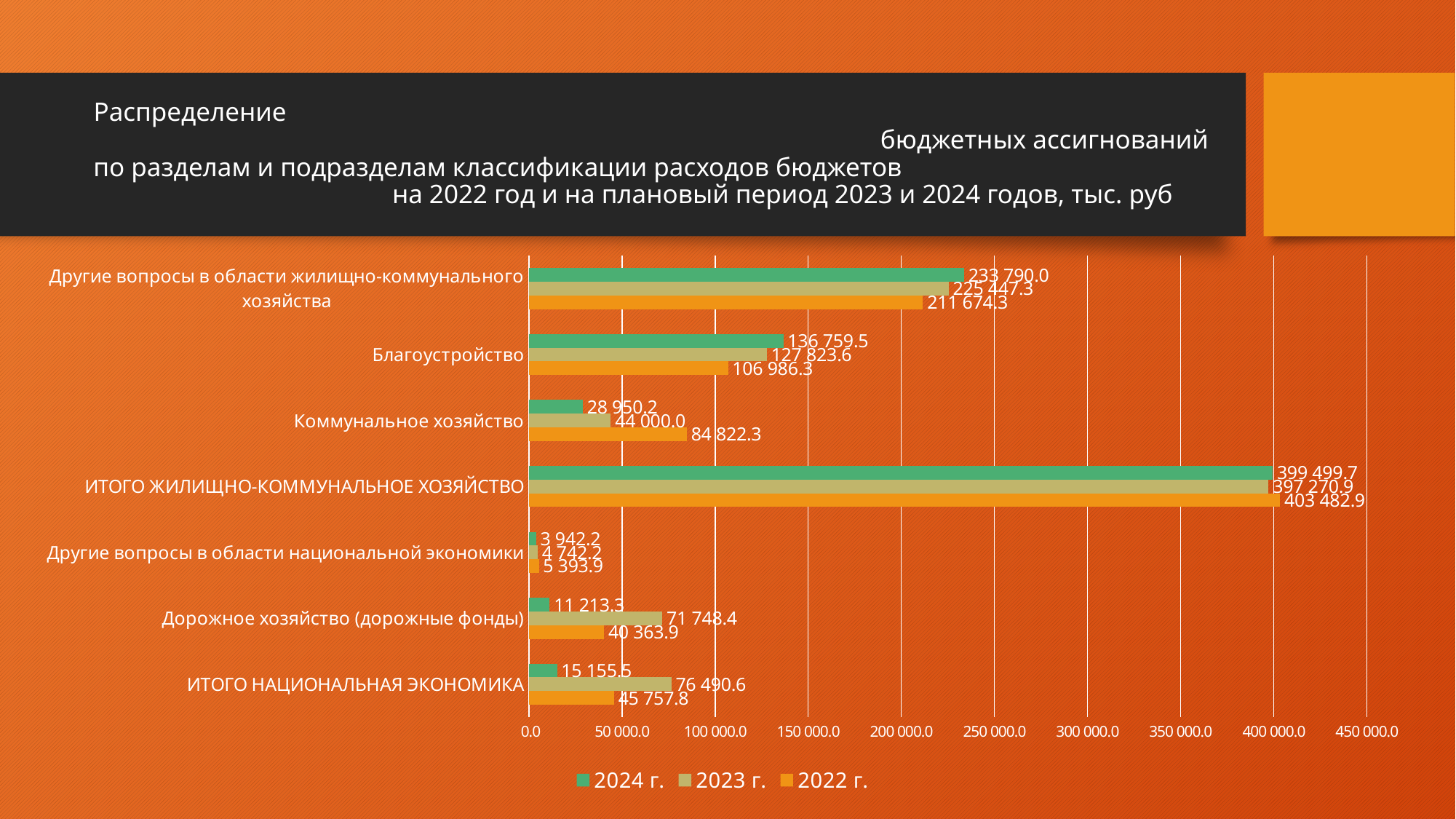
Which category has the lowest value for 2024 г.? Другие вопросы в области национальной экономики What is the difference between the 2022 г. and 2024 г. values for Коммунальное хозяйство? 55 872.1 What kind of chart is shown on the slide? Bar chart What is the value for 2022 г. for ИТОГО ЖИЛИЩНО-КОММУНАЛЬНОЕ ХОЗЯЙСТВО? 403 482.9 Which category has the highest value for 2024 г.? ИТОГО ЖИЛИЩНО-КОММУНАЛЬНОЕ ХОЗЯЙСТВО What is the value for 2023 г. for Дорожное хозяйство (дорожные фонды)? 71 748.4 What is the value for 2022 г. for Коммунальное хозяйство? 84 822.3 How many categories are shown on the chart? 7 How many series does the legend list? 3 What is the value for 2024 г. for Благоустройство? 136 759.5 For ИТОГО НАЦИОНАЛЬНАЯ ЭКОНОМИКА, which is larger: the 2023 г. value or the 2022 г. value? 2023 г. What is the difference between the 2024 г. and 2022 г. values for Благоустройство? 29 773.2